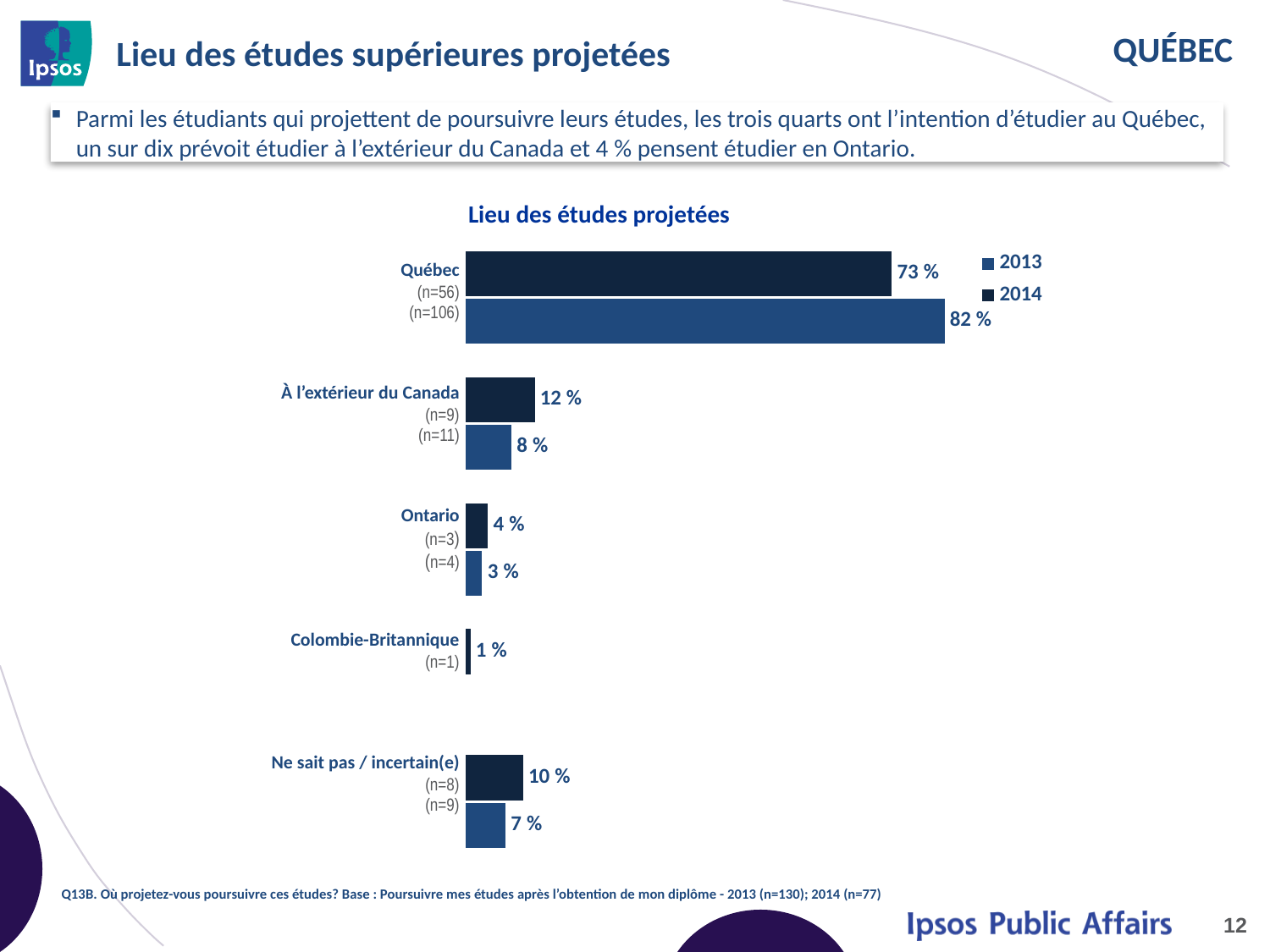
Which is larger for Ontario: the 2013 value or the 2014 value? 2014 What is the title of the chart? Lieu des études projetées What is the value shown for Colombie-Britannique? 1 % What is the 2014 value for Ne sait pas / incertain(e)? 10 % How many series does the legend list? 2 What type of chart is shown on the slide? bar chart What is the 2014 value for Québec? 73 % Which category has the highest 2014 value? Québec What is the 2013 value for Québec? 82 % What is the difference between the 2014 and 2013 values for Québec? 9 % What is the 2013 value for À l'extérieur du Canada? 8 %